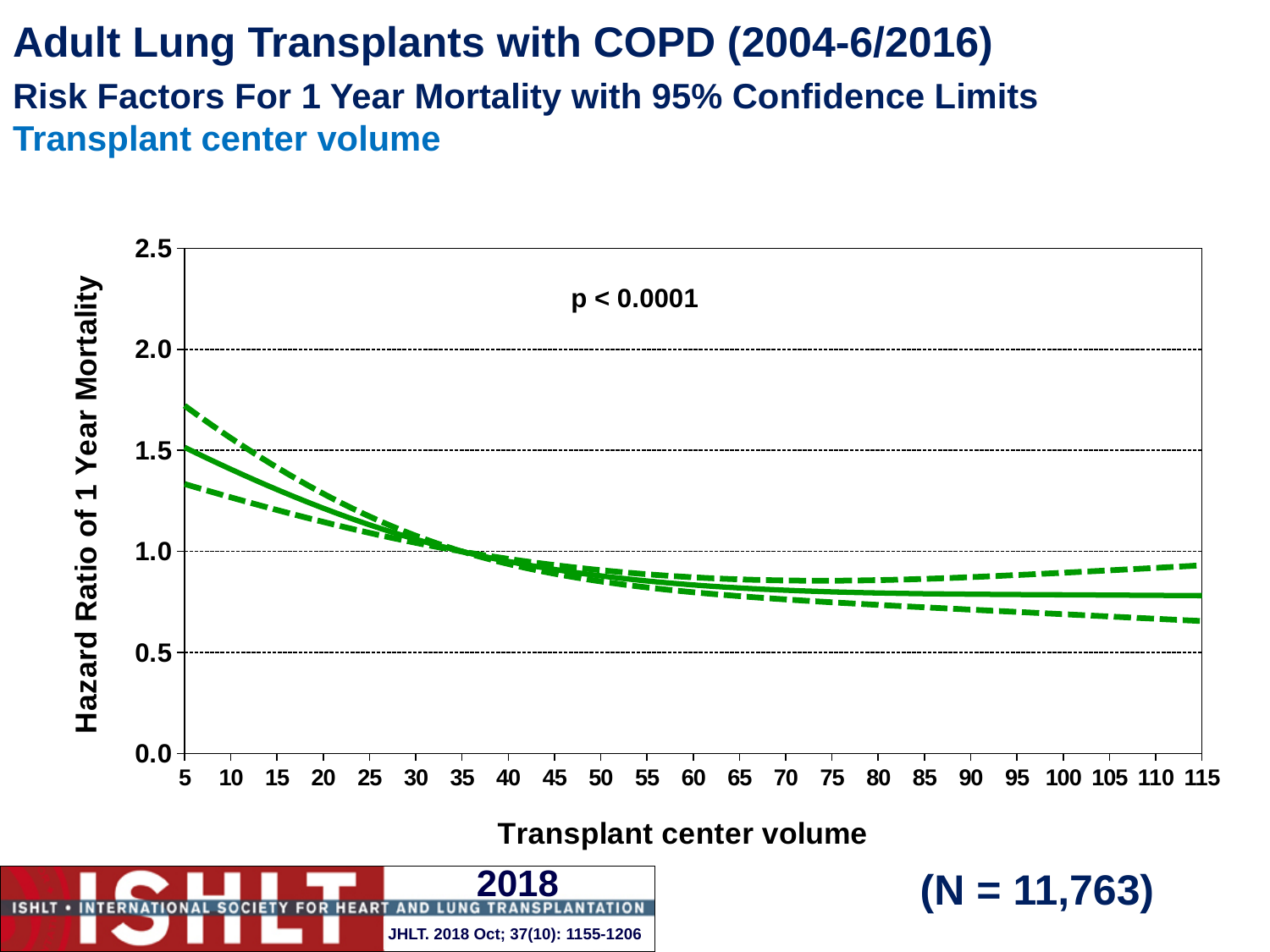
Is the upper confidence limit (upper dashed line) at a transplant center volume of 5 greater or less than 1.5? greater Which is larger, the hazard ratio (solid line) at a transplant center volume of 5 or at 50? 5 What is the label of the y axis? Hazard Ratio of 1 Year Mortality Is the hazard ratio (solid line) at a transplant center volume of 10 greater or less than 1.0? greater Is the hazard ratio (solid line) at a transplant center volume of 115 greater or less than 1.0? less At which transplant center volume shown on the x axis is the hazard ratio (solid line) highest? 5 How many tick labels are shown on the x axis (Transplant center volume)? 23 What kind of chart is shown on the slide? line chart What p-value is printed on the chart? p < 0.0001 Does the hazard ratio (solid line) rise or fall as transplant center volume increases from 5 to 60? fall